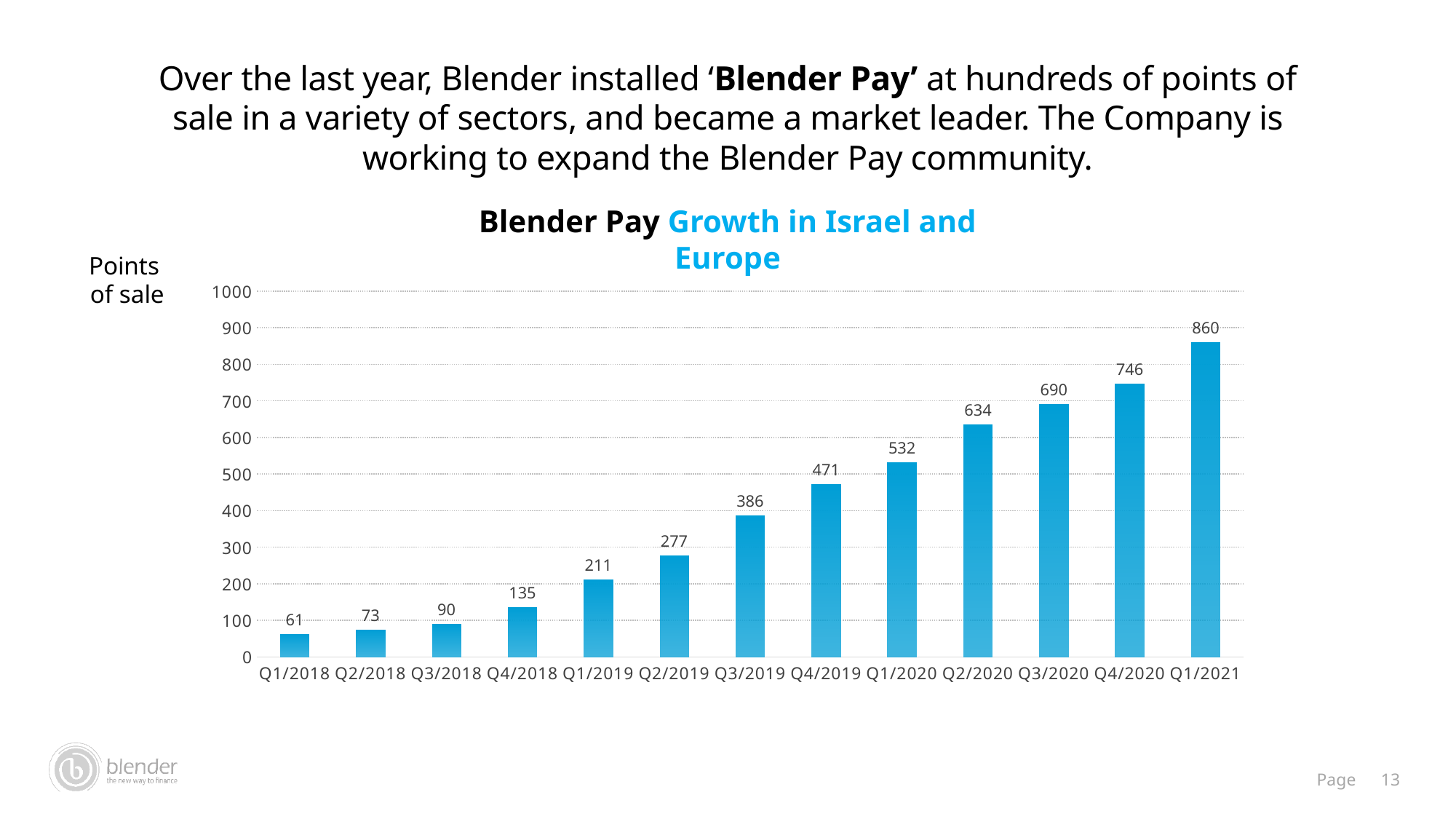
What is the difference in points of sale between Q1/2021 and Q4/2020? 114 What is the title of the chart? Blender Pay Growth in Israel and Europe Which has more points of sale, Q2/2019 or Q4/2018? Q2/2019 Which quarter has the lowest number of points of sale? Q1/2018 What is the difference in points of sale between Q1/2020 and Q1/2019? 321 Do the points of sale rise or fall from Q1/2018 to Q1/2021? Rise What is the number of points of sale in Q1/2018? 61 What is the number of points of sale in Q3/2019? 386 Which quarter has the highest number of points of sale? Q1/2021 How many quarters are shown on the x axis? 13 What is the number of points of sale in Q1/2021? 860 What kind of chart is shown on the slide? Bar chart